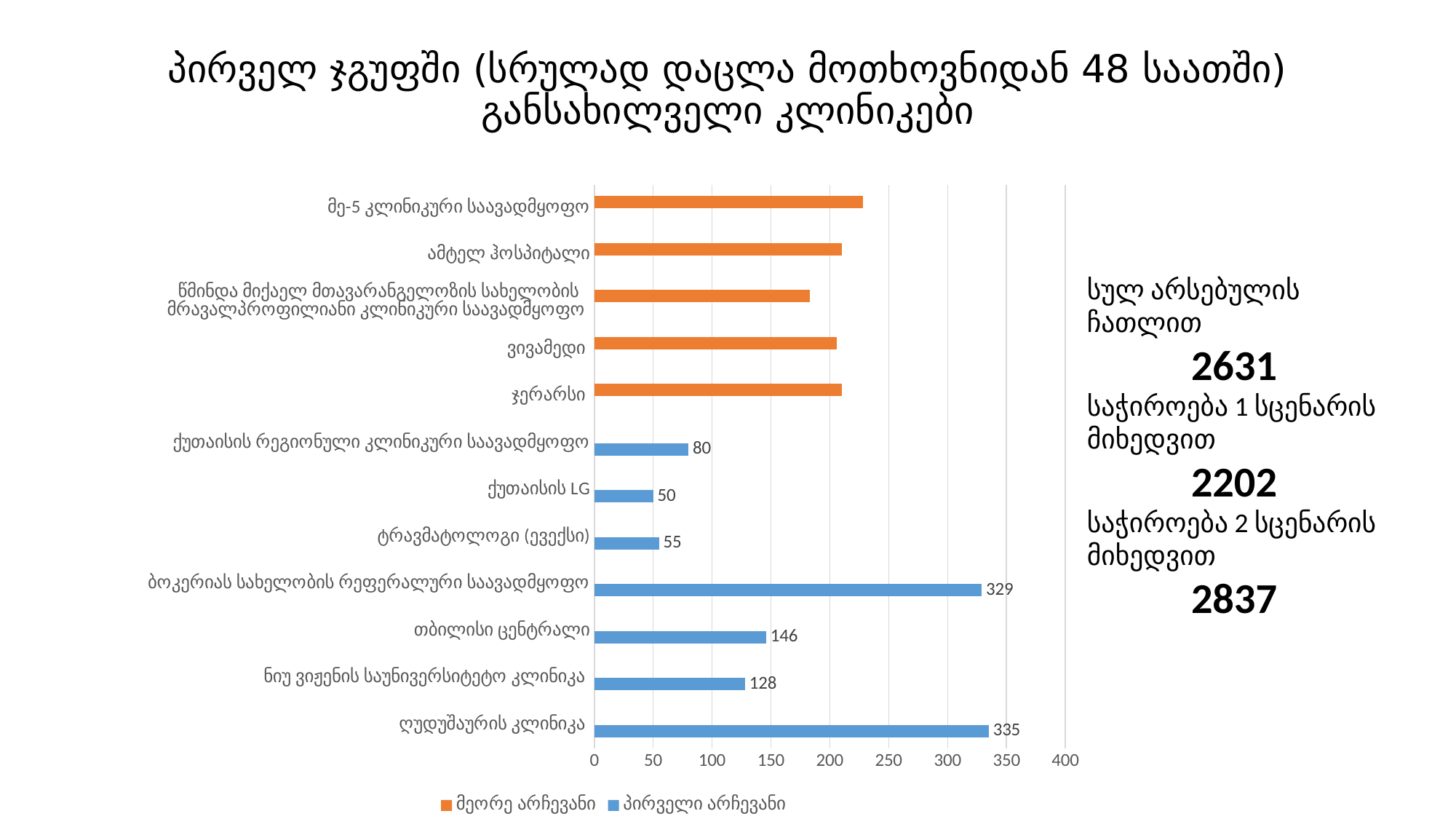
Which category has the highest value in the chart? ლუდუშაურის კლინიკა Is the value for მე-5 კლინიკური საავადმყოფო greater or less than 200? greater What value is shown for თბილისი ცენტრალი? 146 What value is shown for ბოკერიას სახელობის რეფერალური საავადმყოფო? 329 Which category has the lowest value in the chart? ქუთაისის LG What value is shown for ქუთაისის LG? 50 What value is shown for ლუდუშაურის კლინიკა? 335 How many series does the legend list? 2 What is the difference between the values for ლუდუშაურის კლინიკა and ბოკერიას სახელობის რეფერალური საავადმყოფო? 6 How many categories are shown in the chart? 12 What kind of chart is shown on the slide? Bar chart Which is larger: the value for თბილისი ცენტრალი or the value for ნიუ ვიჟენის საუნივერსიტეტო კლინიკა? თბილისი ცენტრალი